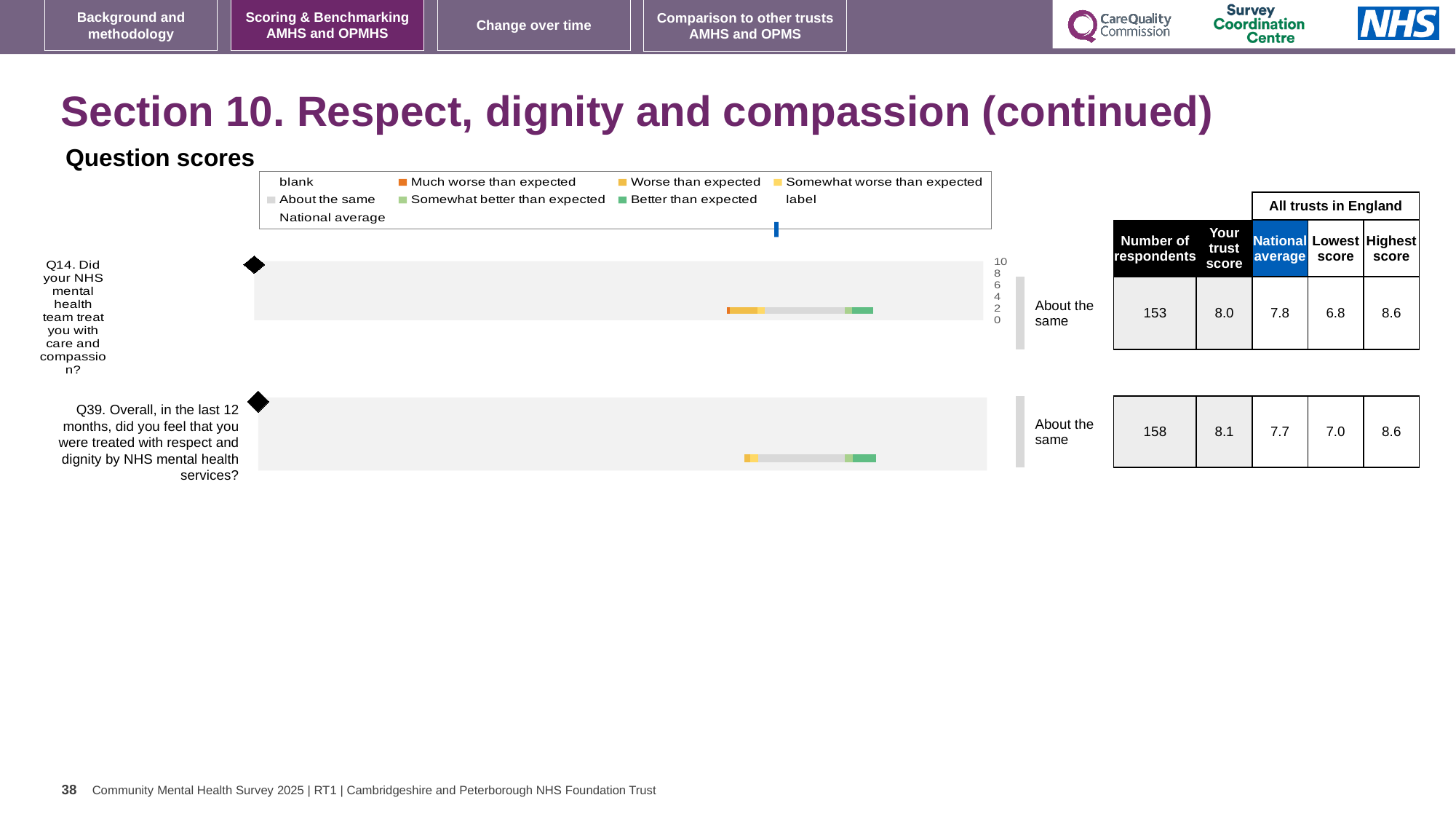
What kind of chart is used to show the question scores on this slide? bar chart What is the trust score for Q39 (treated with respect and dignity)? 8.1 What is the national average score for Q14? 7.8 What is the difference between the highest and lowest scores for Q39? 1.6 What is the national average score for Q39? 7.7 How many respondents answered Q39? 158 Which question has more respondents, Q14 or Q39? Q39 Which question has the higher trust score, Q14 or Q39? Q39 What benchmark rating is shown for Q14 in the chart? About the same What is the trust score for Q14 (care and compassion)? 8.0 What is the lowest score among all trusts in England for Q14? 6.8 How many questions are plotted in the question scores chart? 2